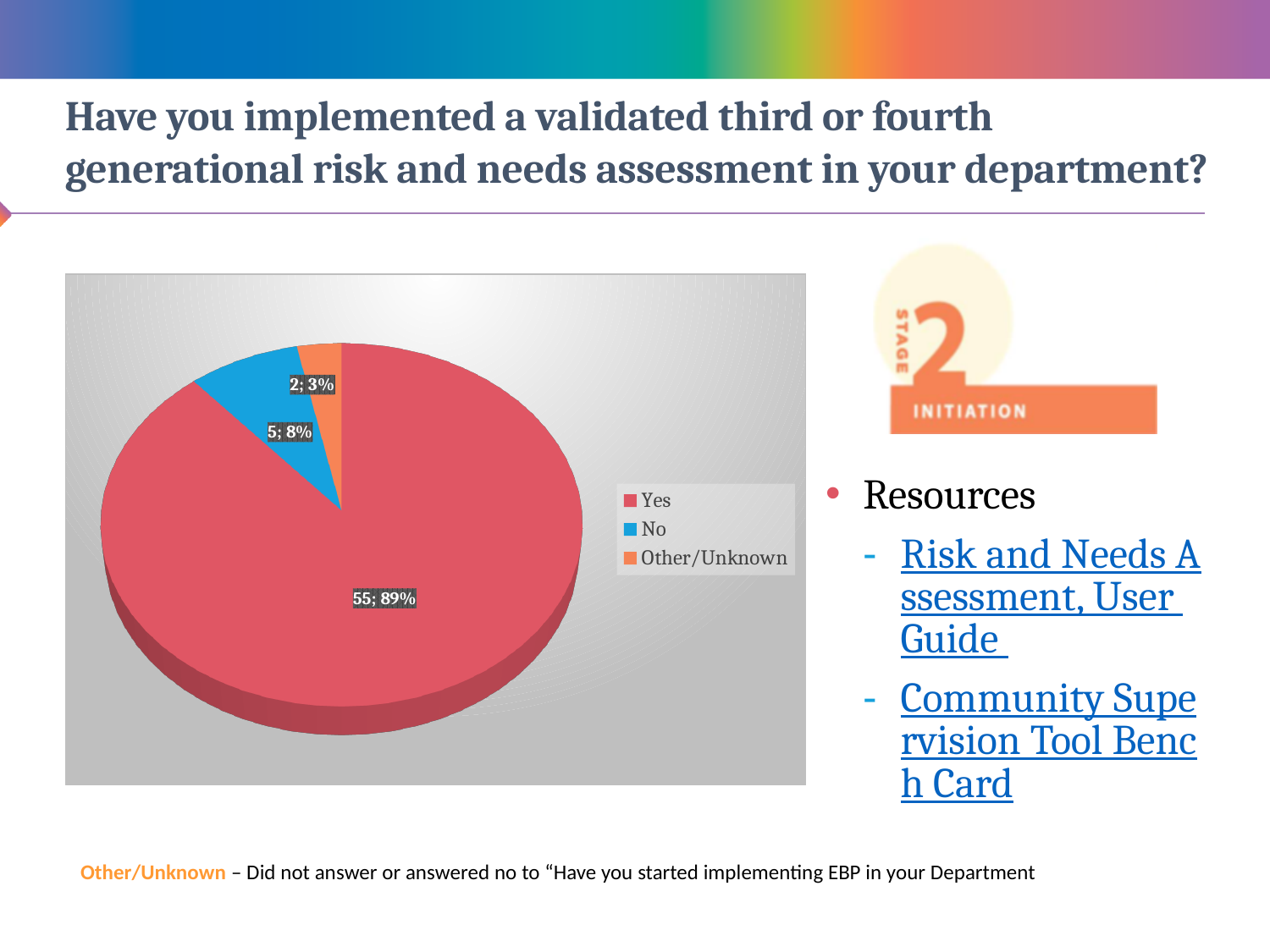
What kind of chart is shown on the slide? pie chart What percentage of the pie does the Yes slice represent? 89% How many categories does the pie chart have? 3 What percentage of the pie does the No slice represent? 8% Which category has the smallest slice? Other/Unknown What colour is the Yes slice in the pie chart? red What is the count for the Yes slice? 55 Which slice is larger, No or Other/Unknown? No Which category has the largest slice? Yes What is the total count across all three slices? 62 What is the difference in count between the Yes and No slices? 50 What is the count for the Other/Unknown slice? 2